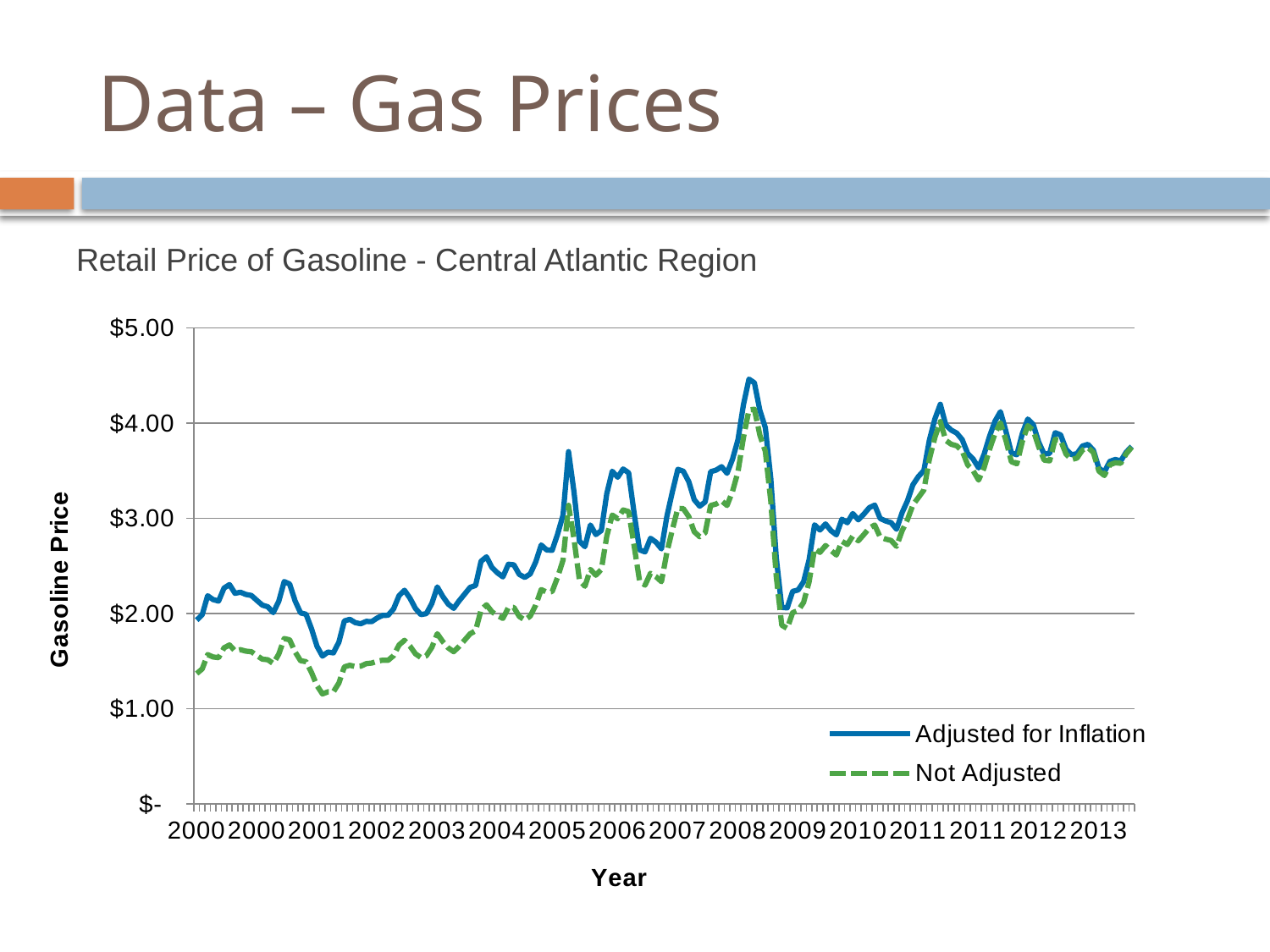
How many series does the chart's legend list? 2 What kind of chart is shown on the slide? line chart Is the peak value of the Adjusted for Inflation series around 2008 greater or less than $4.00? greater Is the peak value of the Not Adjusted series around 2008 greater or less than $3.00? greater In 2000, which series shows the higher gasoline price, Adjusted for Inflation or Not Adjusted? Adjusted for Inflation Is the value of the Not Adjusted series at the start of 2000 greater or less than $2.00? less Which series is drawn with a dashed line? Not Adjusted What is the title of the chart? Retail Price of Gasoline - Central Atlantic Region What is the label on the vertical axis of the chart? Gasoline Price Overall, do gasoline prices rise or fall from 2000 to 2013 in the chart? rise Which series reaches the highest value on the chart? Adjusted for Inflation